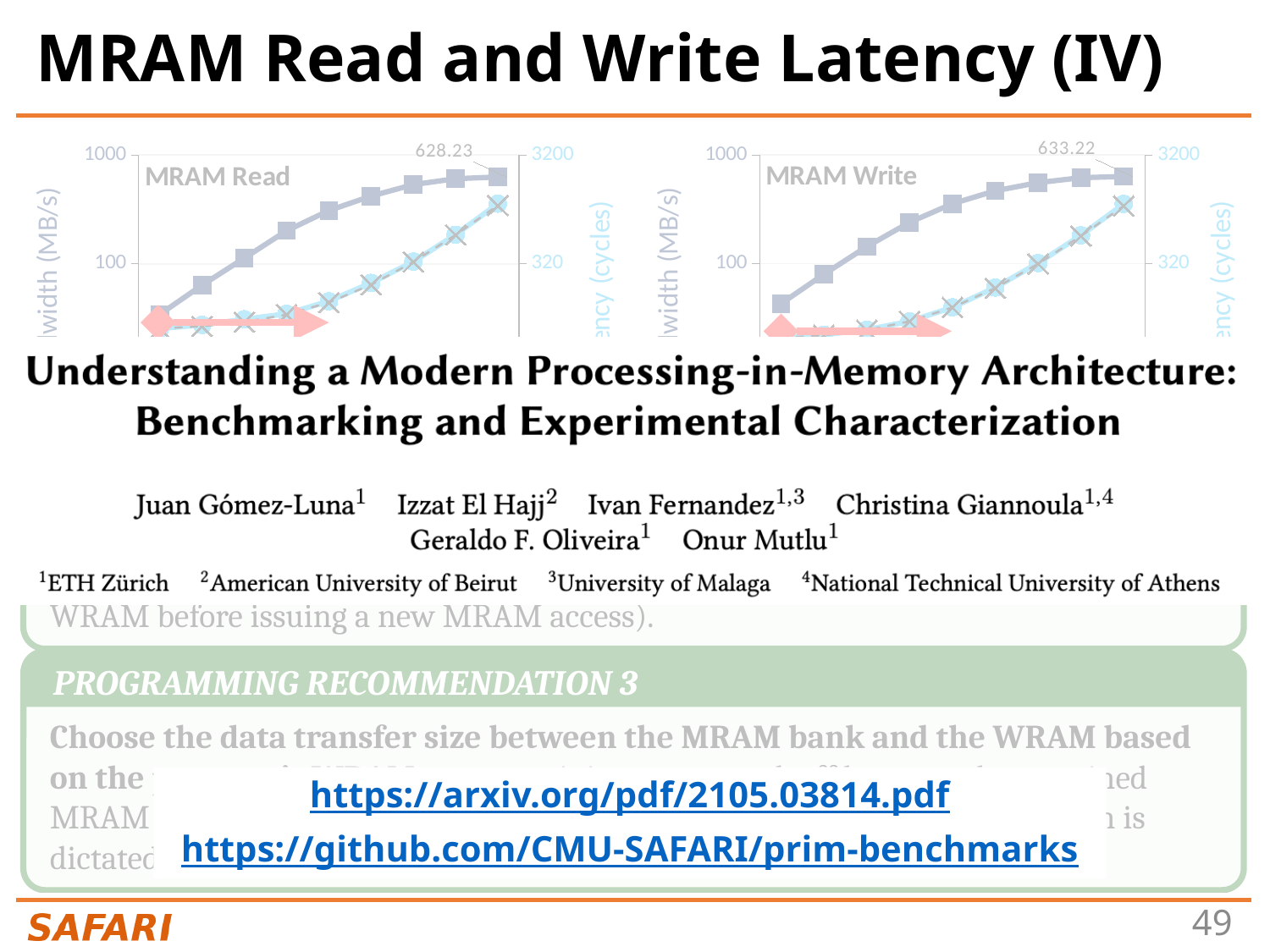
In the MRAM Read chart, what is the value printed as a data label at the top of the chart? 628.23 What is the title of the chart on the left side of the slide? MRAM Read In the MRAM Write chart, is the leftmost point of the square-marker series greater or less than 100 on the left axis? less In the MRAM Read chart, do the plotted values rise or fall from left to right along the x axis? rise In the MRAM Write chart, do the plotted values rise or fall from left to right along the x axis? rise What is the difference between the labeled peak value in the MRAM Write chart (633.22) and the labeled peak value in the MRAM Read chart (628.23)? 4.99 How many charts are shown on the slide? 2 In the MRAM Write chart, what is the value printed as a data label at the top of the chart? 633.22 In the MRAM Read chart, is the leftmost point of the square-marker series greater or less than 100 on the left axis? less What kind of chart is the MRAM Read chart? line chart What is the topmost tick value shown on the right-hand axis of the MRAM Write chart? 3200 Which chart has the larger labeled peak value, MRAM Read or MRAM Write? MRAM Write